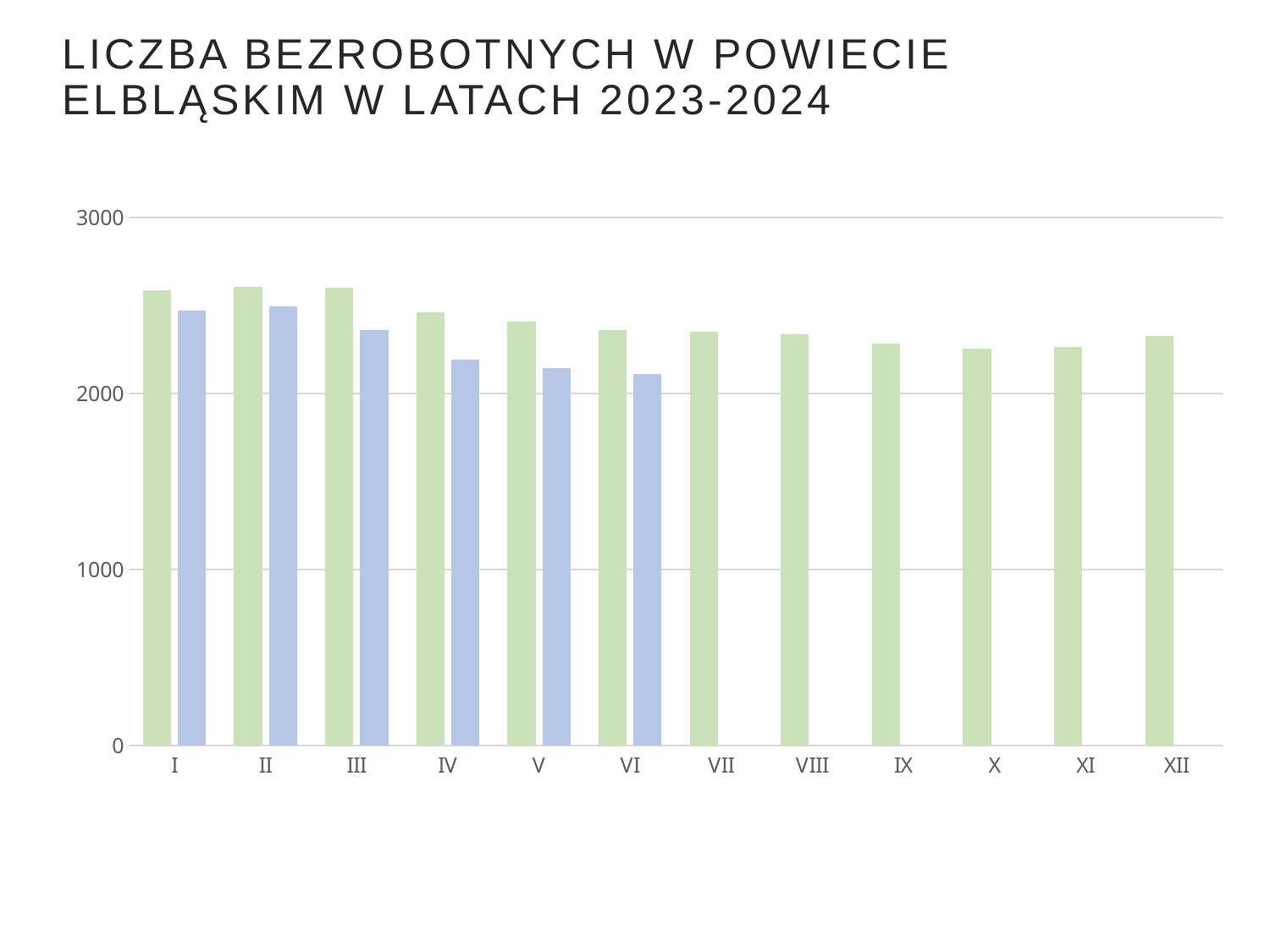
What kind of chart is shown on the slide? bar chart Among the blue bars, which month has the lowest value? VI Is the value of the blue bar for month VI greater or less than 2000? greater Among the blue bars, which month has the highest value? II How many month categories are shown on the x axis? 12 Is the value of the green bar for month II greater or less than 3000? less Is the value of the blue bar for month IV greater or less than 3000? less What is the title of the chart? LICZBA BEZROBOTNYCH W POWIECIE ELBLĄSKIM W LATACH 2023-2024 Do the blue bars rise or fall from month I to month VI? fall For month I, which bar is taller, the green one or the blue one? the green one For how many months is a blue bar plotted? 6